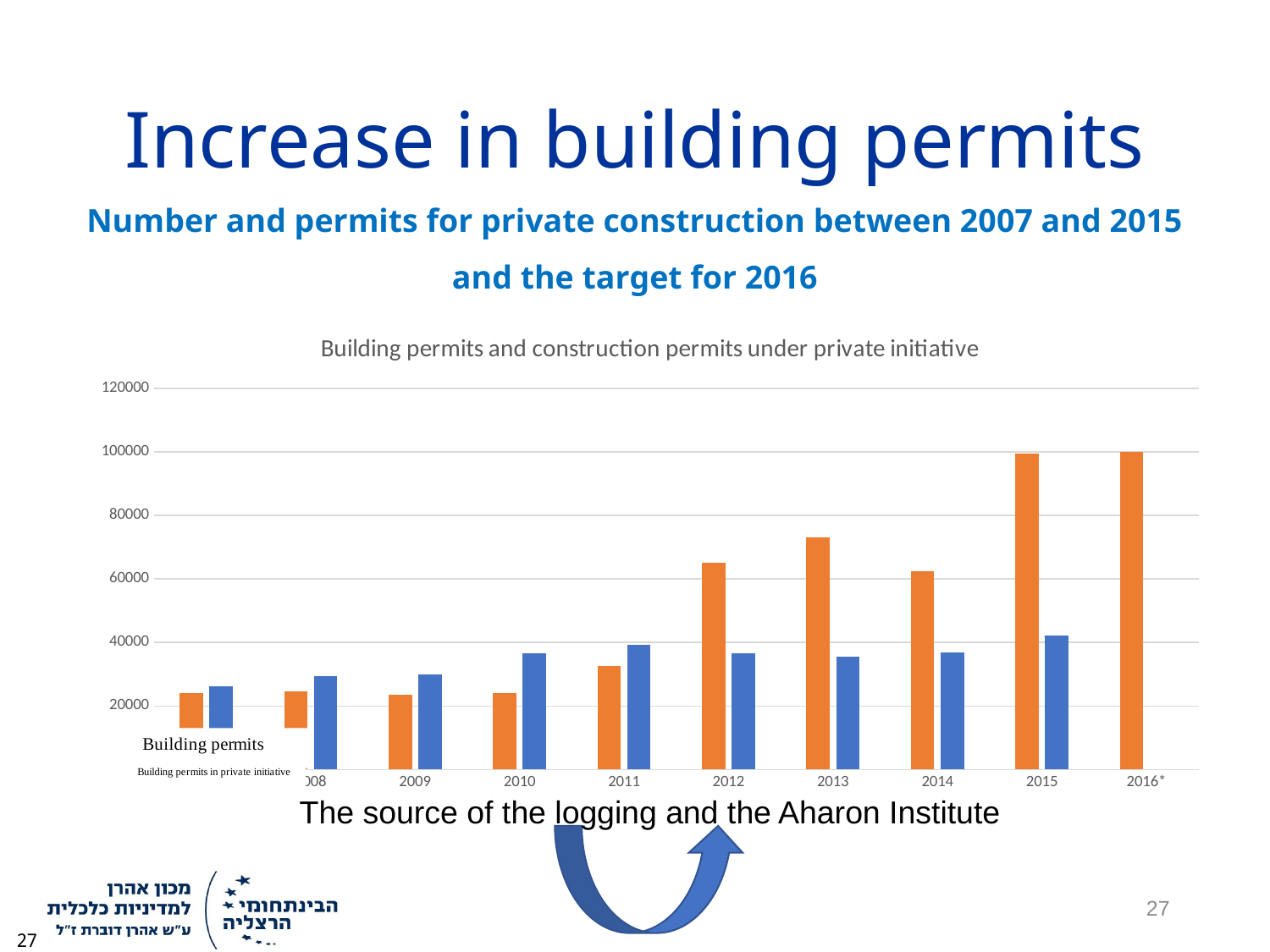
Is the value of the orange bar for 2009 greater or less than 40000? less Do the orange bars rise or fall from 2009 to 2013? rise How many year groups of bars are plotted on the chart? 10 What is the title of the chart? Building permits and construction permits under private initiative Is the value of the blue bar for 2015 greater or less than 60000? less Which is larger for 2012, the orange bar or the blue bar? the orange bar Is the value of the orange bar for 2013 greater or less than 60000? greater Which is larger, the orange bar for 2013 or the orange bar for 2014? 2013 What kind of chart is shown on the slide? bar chart Which year has the highest blue bar? 2015